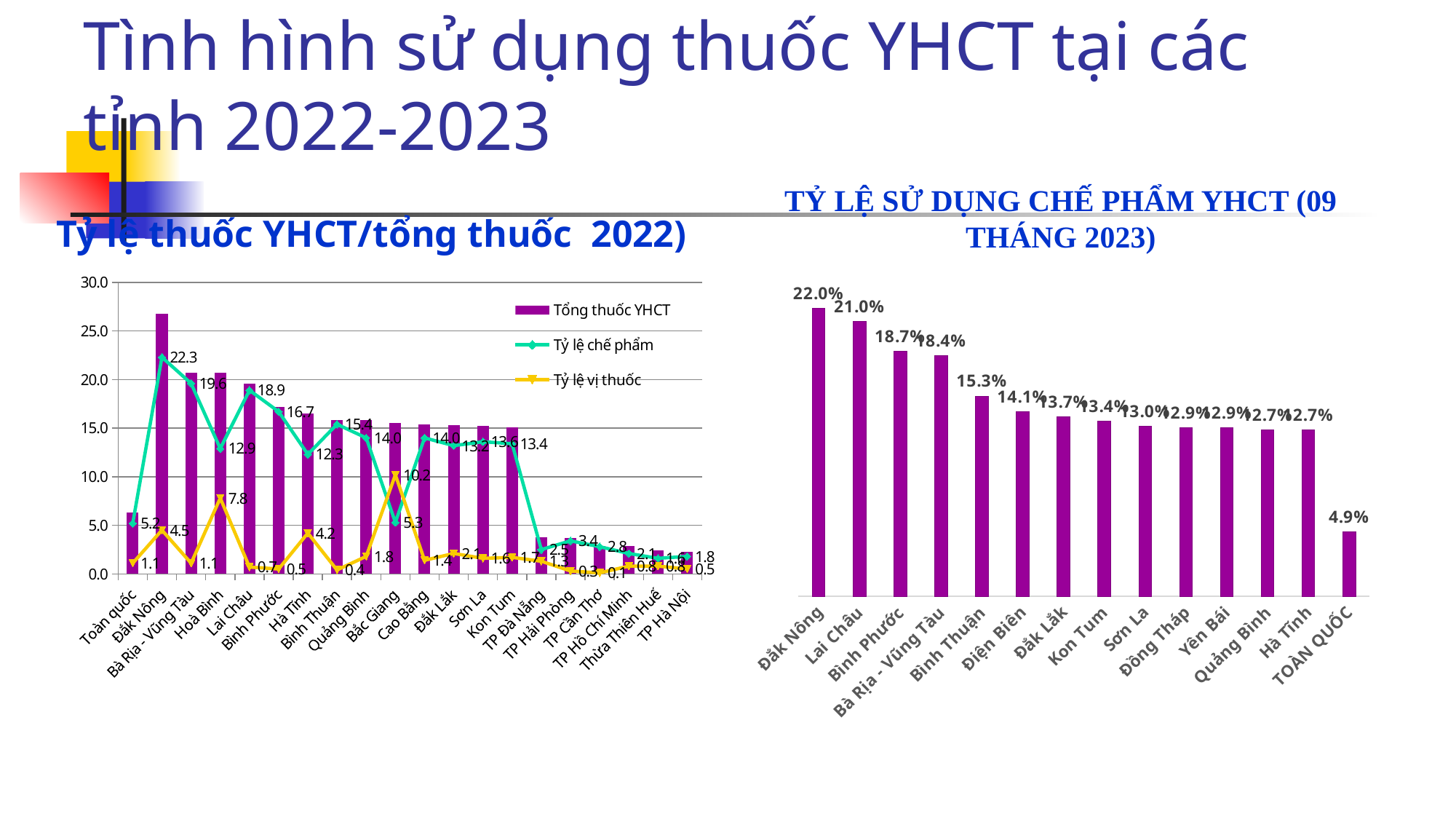
In the right chart (TỶ LỆ SỬ DỤNG CHẾ PHẨM YHCT (09 THÁNG 2023)), do the values rise or fall from left to right? fall In the right chart (TỶ LỆ SỬ DỤNG CHẾ PHẨM YHCT (09 THÁNG 2023)), which category has the lowest value? TOÀN QUỐC In the left chart (Tỷ lệ thuốc YHCT/tổng thuốc 2022), is the Tổng thuốc YHCT bar for Đắk Nông greater or less than 25.0? greater In the right chart (TỶ LỆ SỬ DỤNG CHẾ PHẨM YHCT (09 THÁNG 2023)), which category has the highest value? Đắk Nông In the right chart (TỶ LỆ SỬ DỤNG CHẾ PHẨM YHCT (09 THÁNG 2023)), how many categories are shown? 14 In the right chart (TỶ LỆ SỬ DỤNG CHẾ PHẨM YHCT (09 THÁNG 2023)), what is the value for Đắk Nông? 22.0% In the left chart (Tỷ lệ thuốc YHCT/tổng thuốc 2022), how many series does the legend list? 3 In the left chart (Tỷ lệ thuốc YHCT/tổng thuốc 2022), what is the Tỷ lệ vị thuốc value for Bắc Giang? 10.2 In the left chart (Tỷ lệ thuốc YHCT/tổng thuốc 2022), what is the Tỷ lệ chế phẩm value for Đắk Nông? 22.3 In the right chart (TỶ LỆ SỬ DỤNG CHẾ PHẨM YHCT (09 THÁNG 2023)), which is larger, Bình Phước or Bình Thuận? Bình Phước In the right chart (TỶ LỆ SỬ DỤNG CHẾ PHẨM YHCT (09 THÁNG 2023)), what is the difference between Đắk Nông and Lai Châu? 1.0% In the right chart (TỶ LỆ SỬ DỤNG CHẾ PHẨM YHCT (09 THÁNG 2023)), what is the value for TOÀN QUỐC? 4.9%